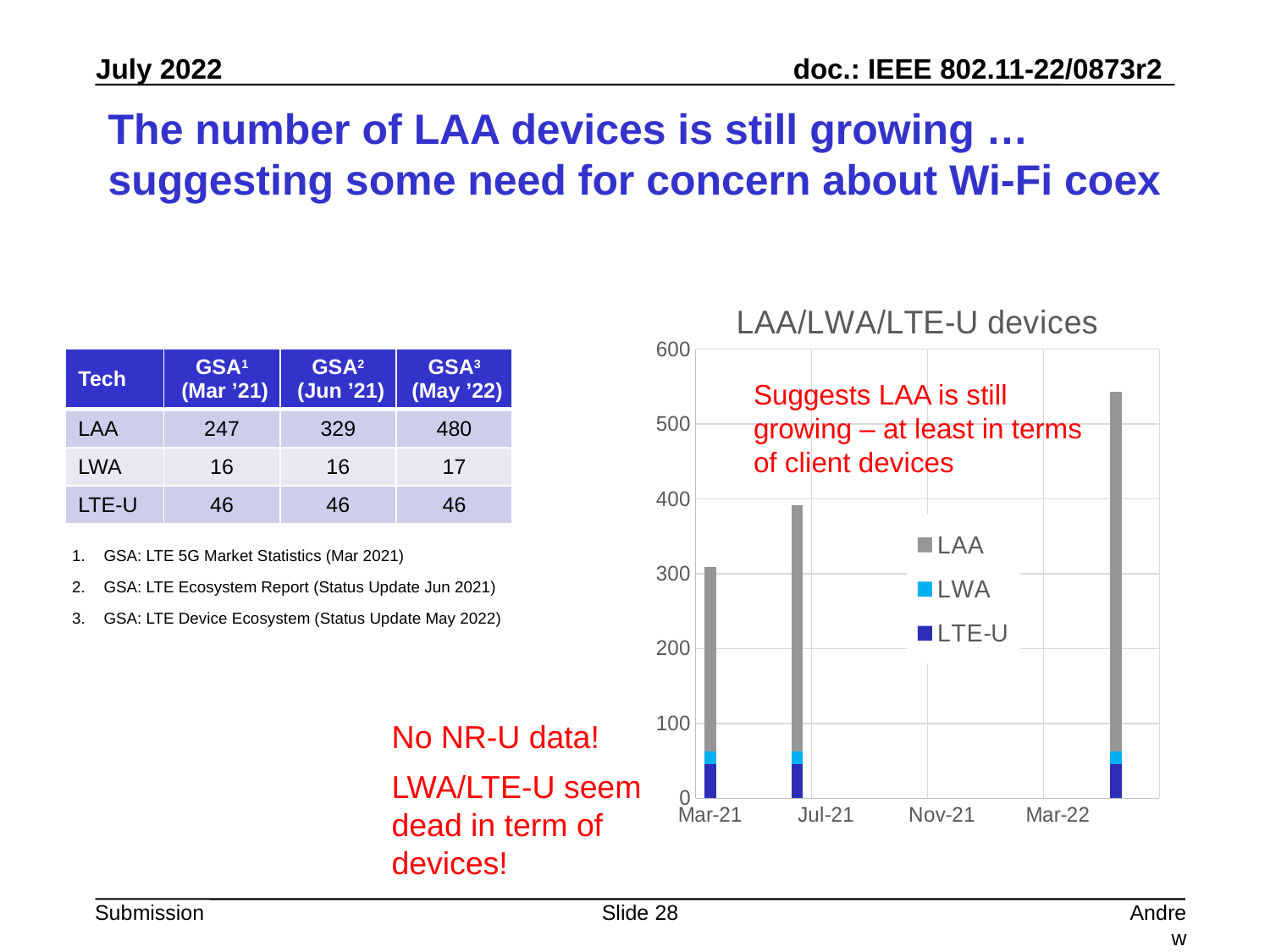
How many stacked bars are plotted in the chart? 3 What is the title of the chart? LAA/LWA/LTE-U devices Do the total bar heights rise or fall from left to right along the x axis? rise Is the total height of the middle bar greater or less than 300? greater Which series are listed in the chart's legend? LAA, LWA, LTE-U Which bar has the greatest total height? The rightmost bar What type of chart is shown on the slide? Stacked bar chart Is the total height of the first (Mar-21) bar greater or less than 200? greater Is the total height of the rightmost bar greater or less than 500? greater In the rightmost bar, which segment is larger: LAA or LTE-U? LAA How many series does the chart's legend list? 3